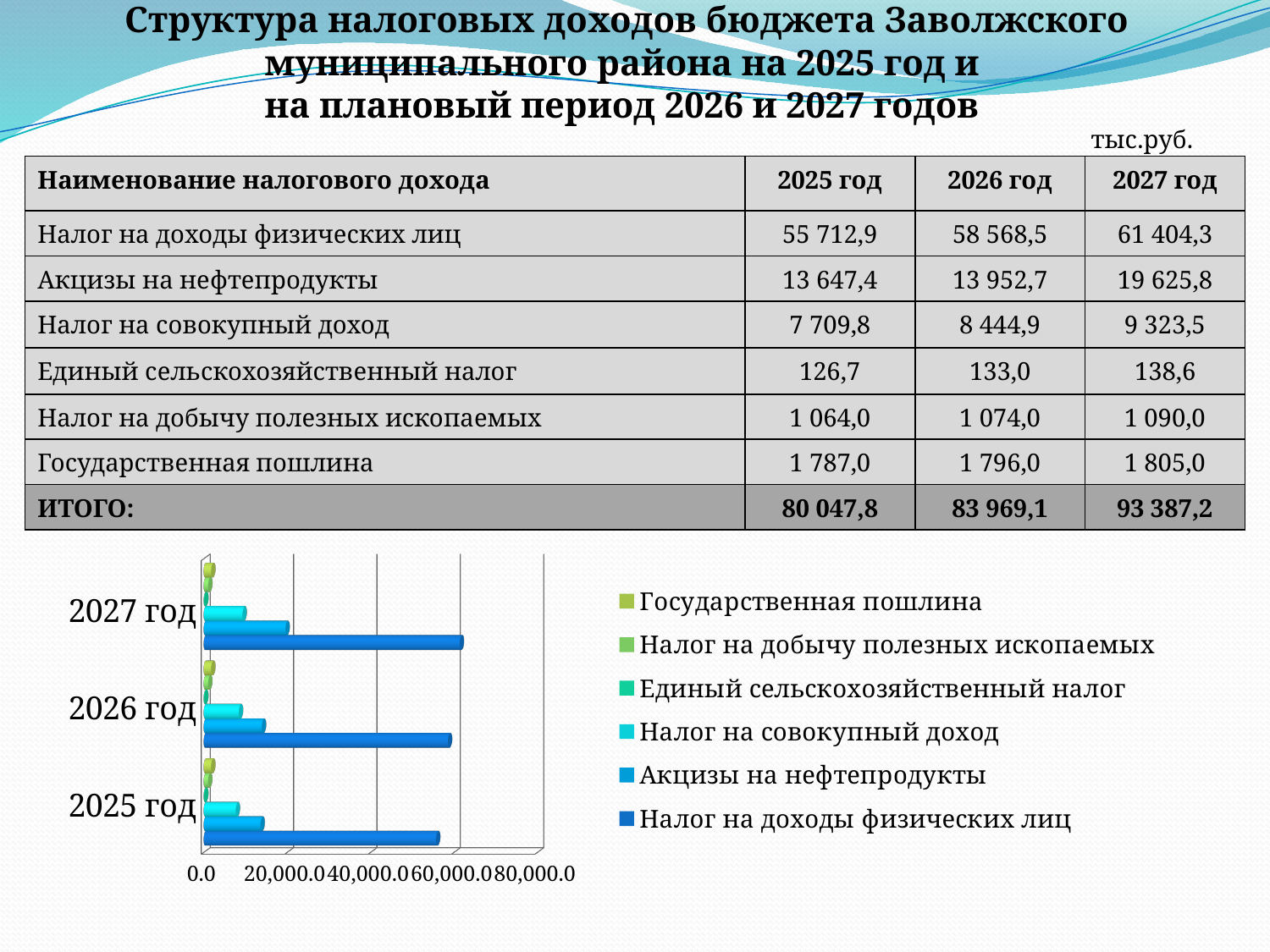
Is the bar for Налог на доходы физических лиц in 2027 год greater or less than 40,000.0? greater Which series is listed last in the chart legend? Налог на доходы физических лиц Is the bar for Налог на совокупный доход in 2025 год greater or less than 20,000.0? less According to the slide, what is the value of Акцизы на нефтепродукты for 2027 год (тыс.руб.)? 19 625,8 Which year has the longest bar for Налог на доходы физических лиц? 2027 год Does the bar for Налог на доходы физических лиц rise or fall from 2025 год to 2027 год? rises What is the difference between Налог на доходы физических лиц in 2027 год and in 2025 год (тыс.руб.)? 5 691,4 How many series does the chart legend list? 6 What kind of chart is shown at the bottom of the slide? bar chart Which is larger: the Акцизы на нефтепродукты bar for 2027 год or for 2025 год? 2027 год According to the slide, what is the value of Налог на доходы физических лиц for 2025 год (тыс.руб.)? 55 712,9 How many year categories are shown on the chart's vertical axis? 3